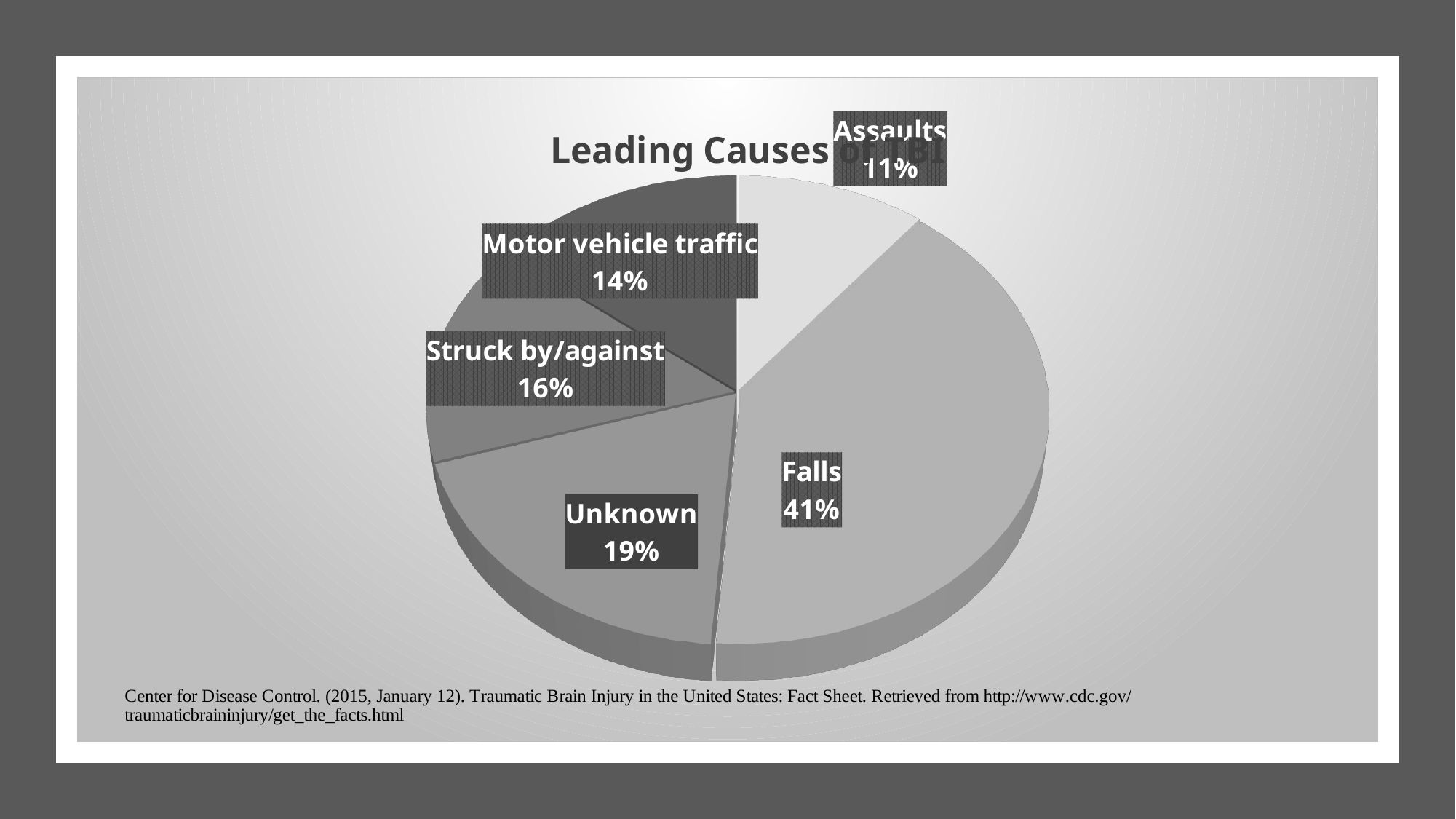
What is the title of the chart? Leading Causes of TBI What kind of chart is shown on the slide? Pie chart What percentage is shown for Motor vehicle traffic? 14% What share of the pie does Falls account for? 41% What percentage is shown for Unknown? 19% How many slices does the pie chart have? 5 What percentage is shown for Struck by/against? 16% Which cause has the largest share of the pie? Falls Which cause has the smallest share of the pie? Assaults Which has a larger share, Struck by/against or Motor vehicle traffic? Struck by/against What percentage is shown for Assaults? 11% What is the difference in percentage points between Falls and Unknown? 22